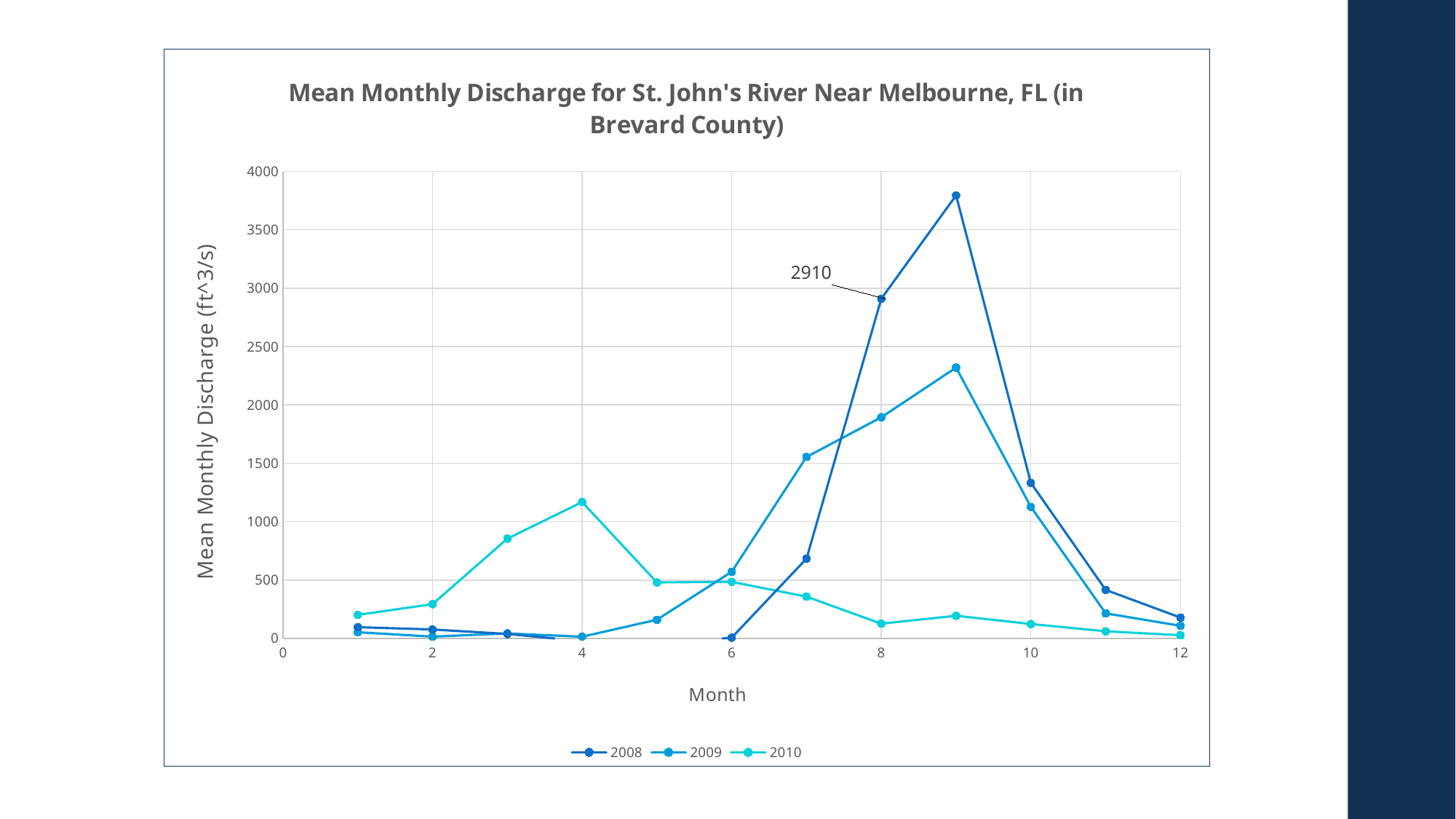
In which month does the 2010 series reach its peak? 4 What is the label on the y axis? Mean Monthly Discharge (ft^3/s) What is the labelled value for the 2008 series at month 8? 2910 Is the value for 2010 at month 4 greater or less than 1000? greater How many series does the legend list? 3 Is the value for 2009 at month 9 greater or less than 2500? less In which month does the 2008 series reach its peak? 9 Does the 2008 series rise or fall from month 9 to month 12? fall What kind of chart is shown on the slide? line chart Which series reaches the highest value on the chart? 2008 Is the value for 2008 at month 9 greater or less than 3500? greater At month 8, which series has the larger value, 2008 or 2009? 2008